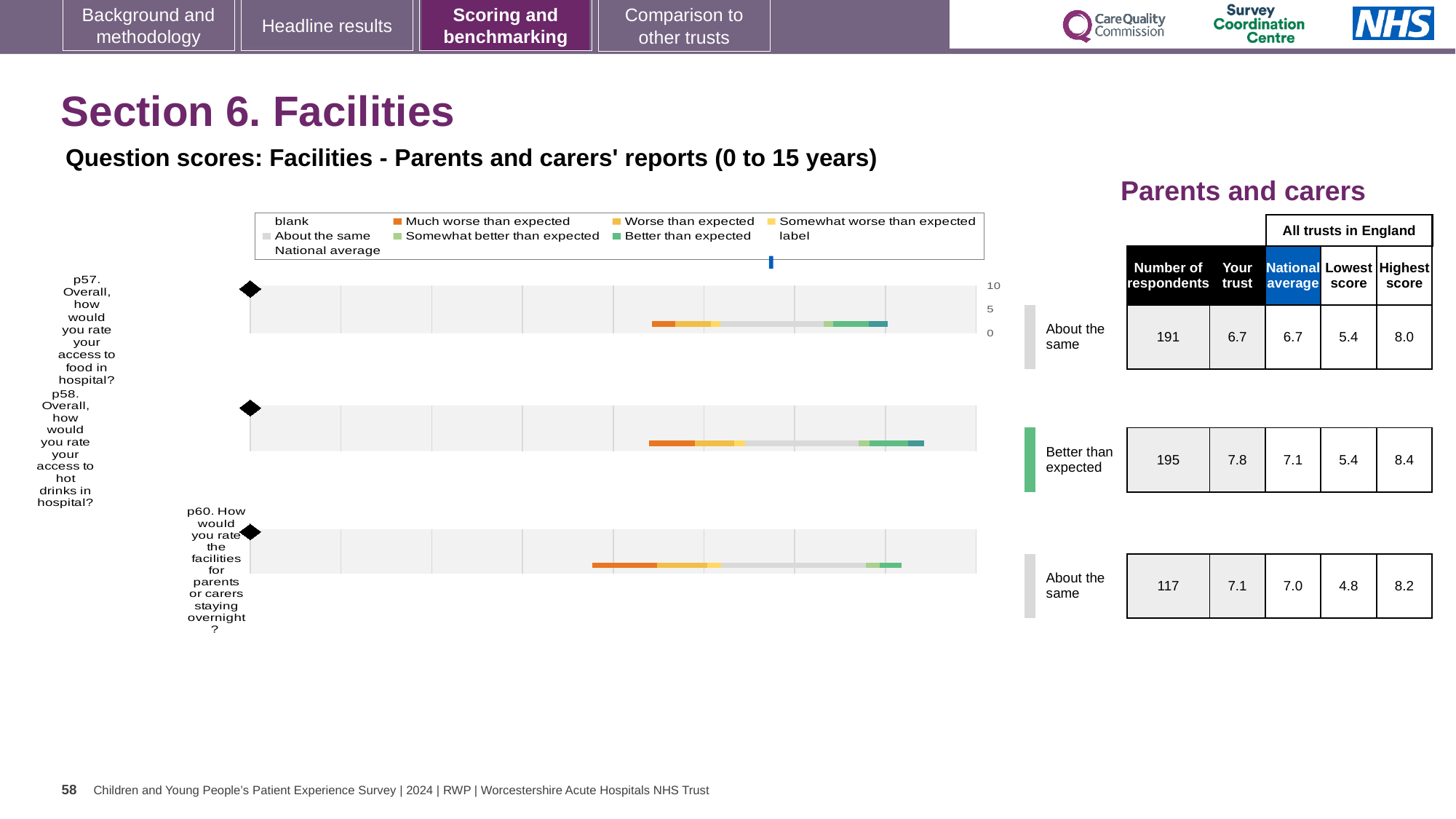
Which legend entry is shown in orange? Much worse than expected How many questions (categories) are plotted in the chart? 3 According to the table beside the chart, what is the 'Your trust' score for p58 (access to hot drinks in hospital)? 7.8 How many entries does the chart legend list? 9 According to the table beside the chart, what is the national average for p57 (access to food in hospital)? 6.7 What is the difference between the 'Your trust' score and the national average for p58 in the table beside the chart? 0.7 Is the 'Your trust' score for p60 in the table beside the chart larger or smaller than its national average? larger Which of the three questions has the highest 'Your trust' score in the table beside the chart? p58. Overall, how would you rate your access to hot drinks in hospital? What is the highest tick value shown on the chart's axis? 10 According to the table beside the chart, how many respondents answered p60 (facilities for parents or carers staying overnight)? 117 Which of the three questions has the lowest 'Your trust' score in the table beside the chart? p57. Overall, how would you rate your access to food in hospital? What kind of chart is shown on the slide? bar chart